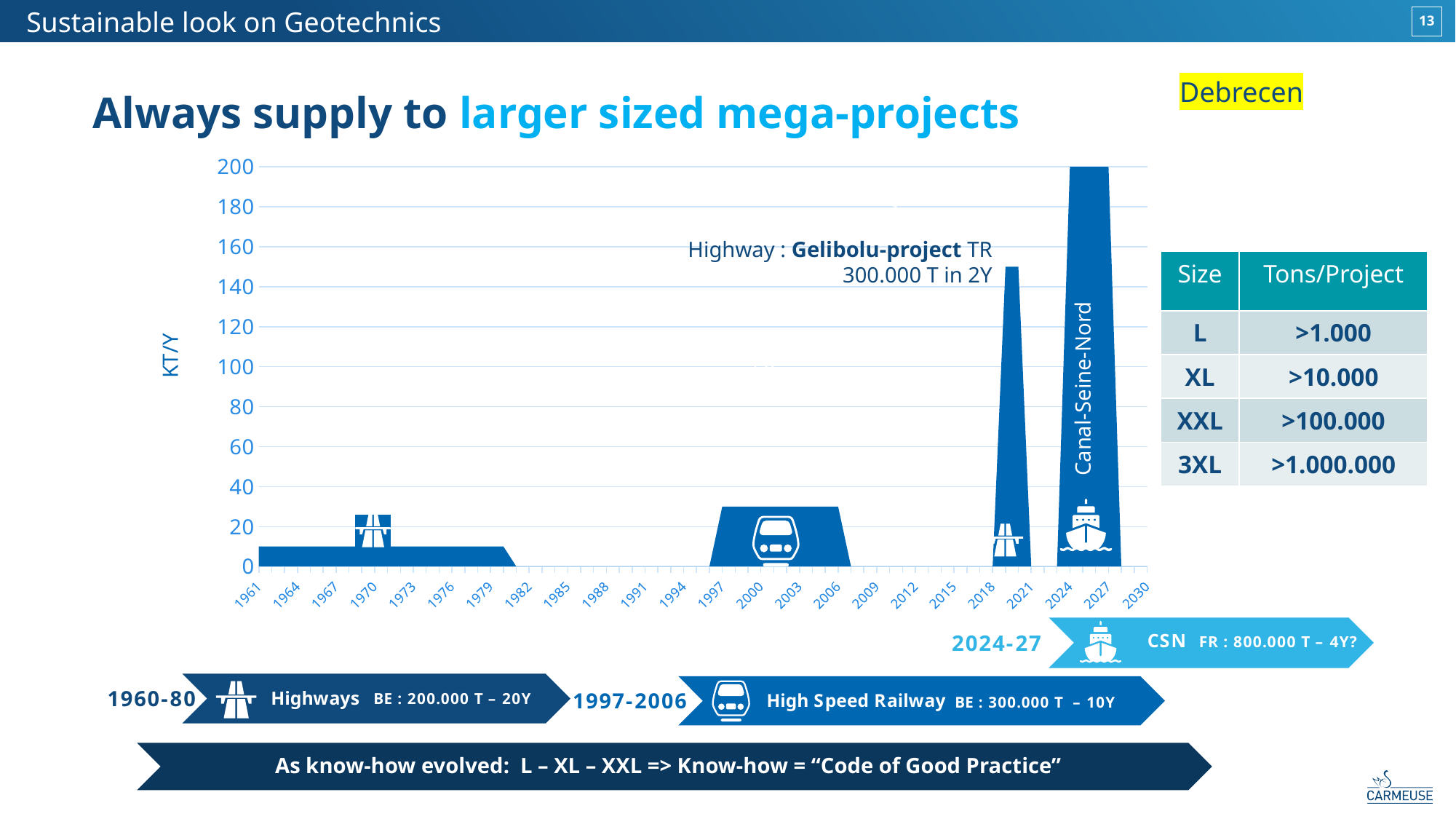
Is the peak value for Canal-Seine-Nord greater or less than 180? greater Is the peak value for the Gelibolu-project greater or less than 160? less What kind of chart is shown on the slide? area chart Is the value for the High Speed Railway period (1997-2006) greater or less than 20? greater Which is larger: the peak for the Gelibolu-project or the peak for Canal-Seine-Nord? Canal-Seine-Nord What is the label of the y axis of the chart? KT/Y What is the first year shown on the x axis of the chart? 1961 Do the peak values of the projects rise or fall from left to right along the x axis? rise What is the highest value shown on the y axis of the chart? 200 Which project has the highest peak in the chart? Canal-Seine-Nord